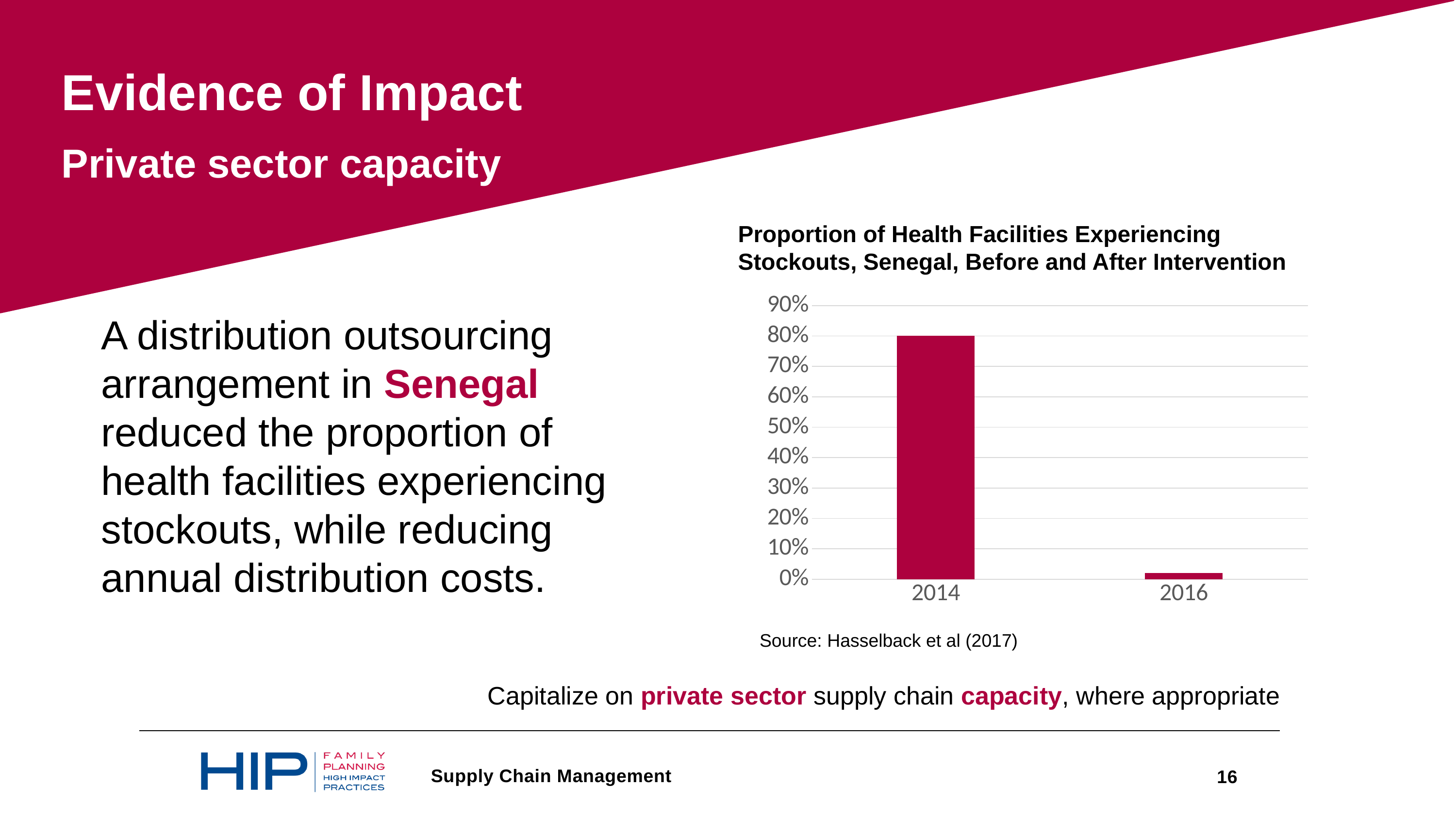
What is the proportion of health facilities experiencing stockouts in 2014? 80% What is the title of the chart? Proportion of Health Facilities Experiencing Stockouts, Senegal, Before and After Intervention Is the value for 2016 greater or less than 10%? less Is the value for 2014 larger or smaller than the value for 2016? Larger Is the value for 2014 greater or less than 50%? greater How many years are shown on the x axis of the chart? 2 Which year has the lowest proportion of health facilities experiencing stockouts? 2016 Do the values rise or fall from 2014 to 2016? Fall What kind of chart is shown on the slide? Bar chart Which year has the highest proportion of health facilities experiencing stockouts? 2014 What source is cited below the chart? Hasselback et al (2017)